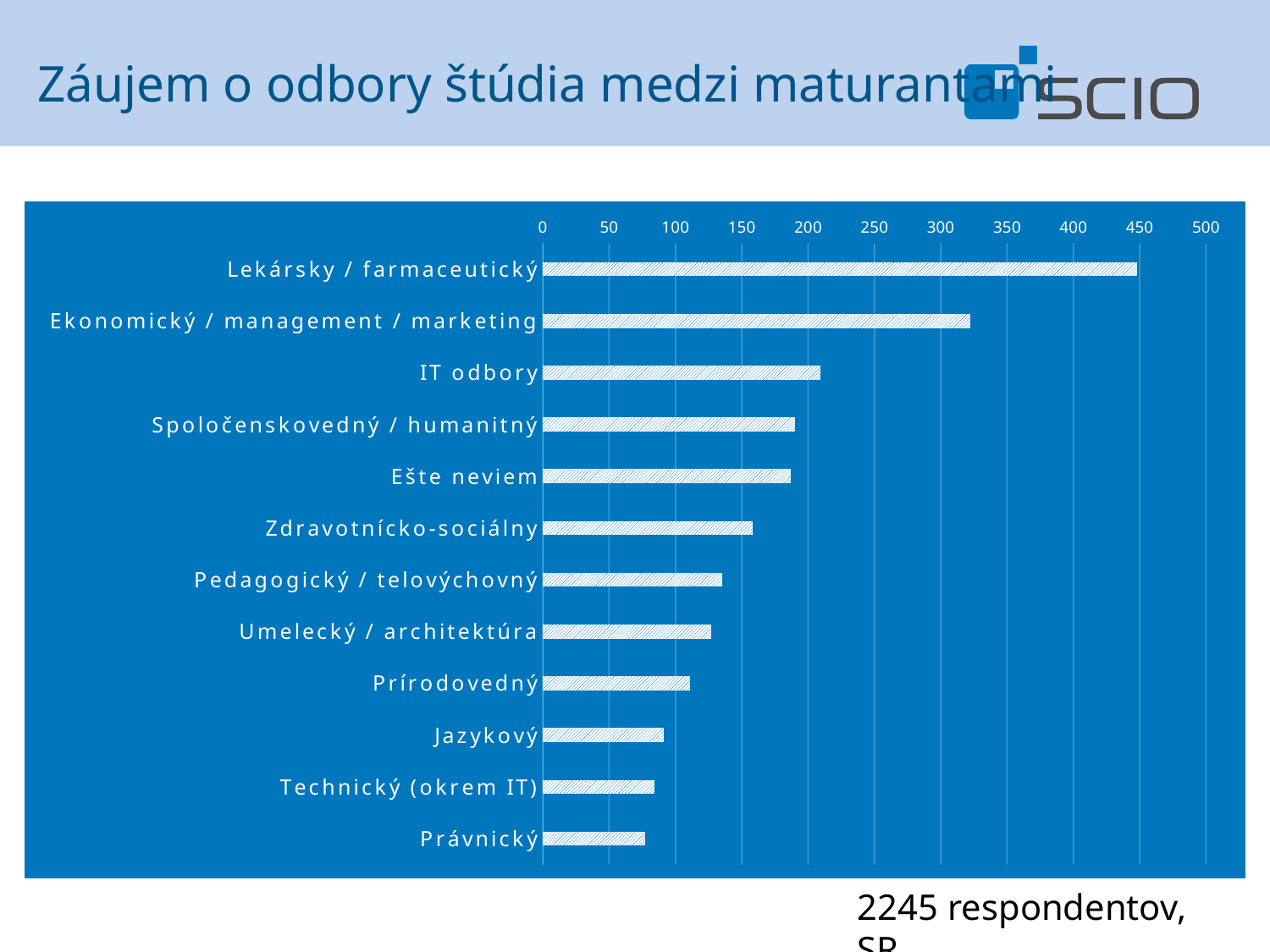
Is the value for Jazykový greater or less than 100? less What is the title of the slide containing the chart? Záujem o odbory štúdia medzi maturantami Is the value for Právnický greater or less than 100? less Which has a larger value, Ekonomický / management / marketing or Lekársky / farmaceutický? Lekársky / farmaceutický Is the value for Ekonomický / management / marketing greater or less than 300? greater Which study field has the highest value in the chart? Lekársky / farmaceutický How many study fields (categories) are shown in the chart? 12 What kind of chart is shown on the slide? bar chart Which has a larger value, IT odbory or Jazykový? IT odbory